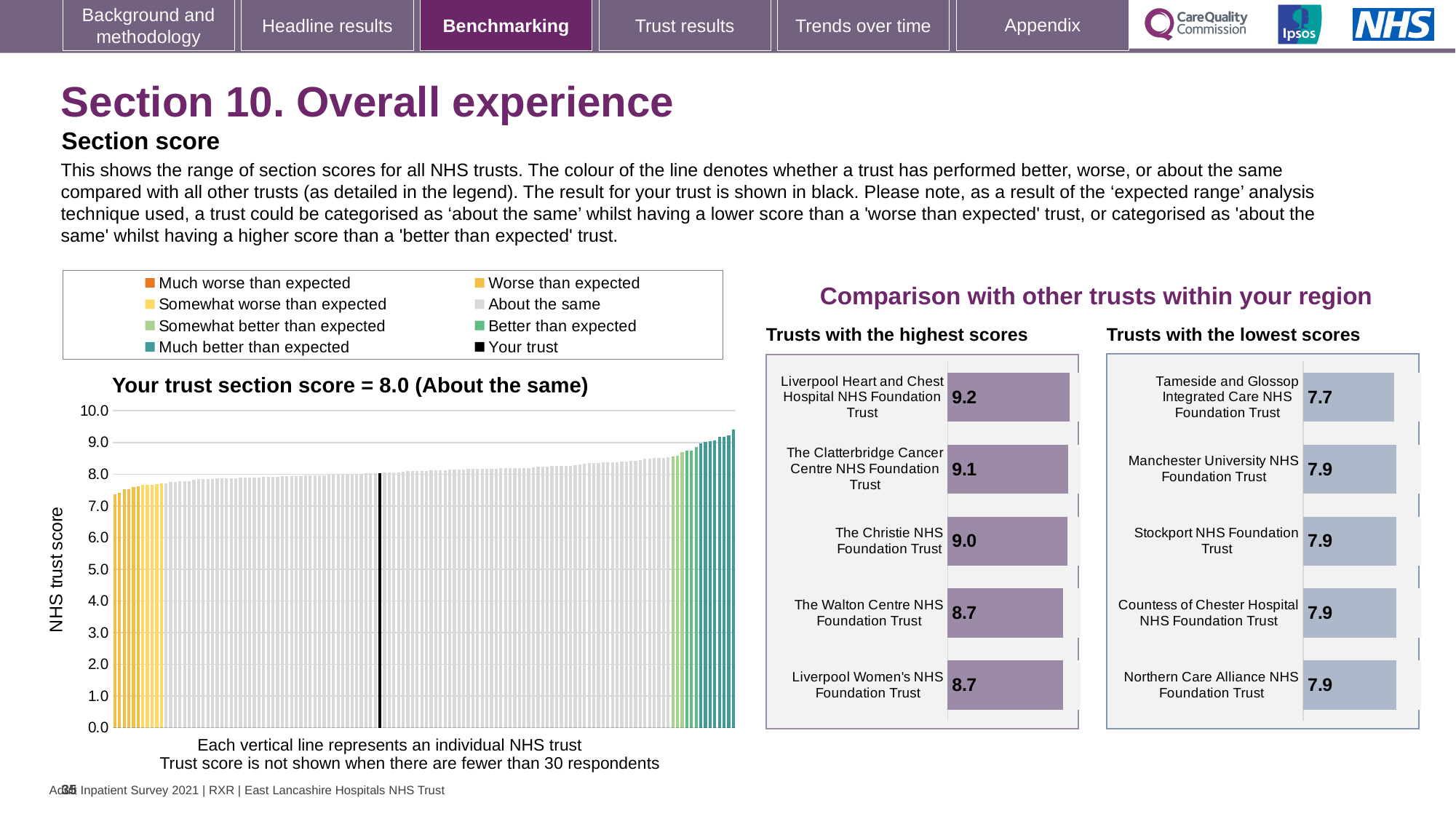
In the 'Your trust section score' chart, is the value of the rightmost bar greater or less than 9.0? greater What kind of chart is the 'Your trust section score' chart? bar chart In the 'Trusts with the lowest scores' chart, which trust has the lowest score? Tameside and Glossop Integrated Care NHS Foundation Trust In the 'Your trust section score' chart, is the value of the leftmost bar greater or less than 8.0? less How many trusts are shown in the 'Trusts with the lowest scores' chart? 5 In the 'Your trust section score' chart, do the bars rise or fall from left to right? rise In the 'Your trust section score' chart, what is the section score for your trust? 8.0 In the 'Trusts with the highest scores' chart, what is the difference between the scores of Liverpool Heart and Chest Hospital NHS Foundation Trust and The Walton Centre NHS Foundation Trust? 0.5 In the 'Trusts with the highest scores' chart, which trust has the highest score? Liverpool Heart and Chest Hospital NHS Foundation Trust What is the y-axis label of the 'Your trust section score' chart? NHS trust score In the 'Trusts with the highest scores' chart, what is the score for The Christie NHS Foundation Trust? 9.0 How many entries does the legend above the 'Your trust section score' chart list? 8